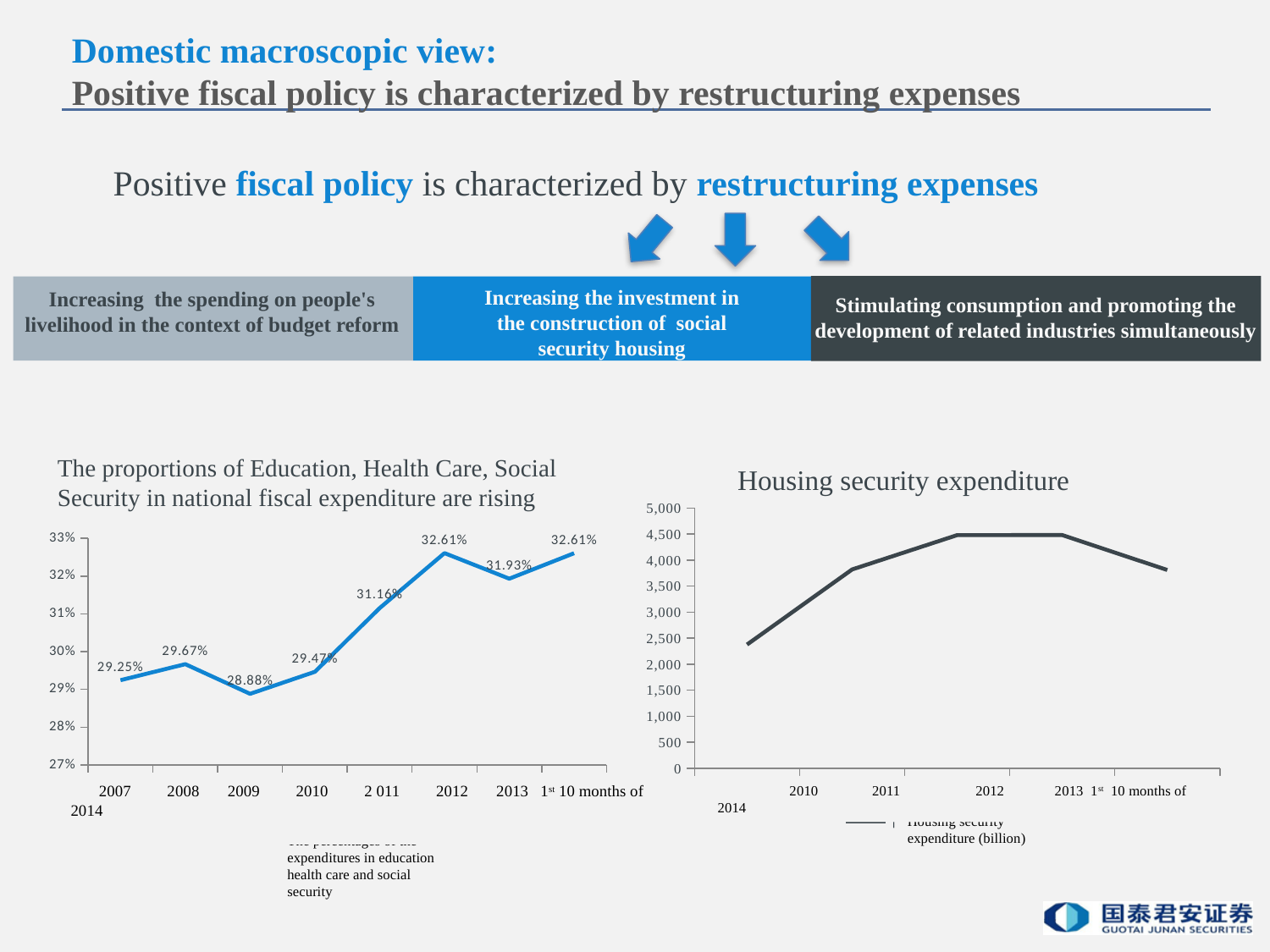
In the 'Housing security expenditure' chart, is the value for 2010 greater or less than 3,000? less How many data points are plotted in the 'Housing security expenditure' chart? 5 In the 'Housing security expenditure' chart, which year has the lowest value? 2010 In the left chart on the proportions of Education, Health Care, Social Security, which year has the lowest value? 2009 What kind of chart is the 'Housing security expenditure' chart? Line chart How many data points are plotted in the left chart on the proportions of Education, Health Care, Social Security? 8 In the 'Housing security expenditure' chart, do the values rise or fall from 2010 to 2012? rise In the left chart on the proportions of Education, Health Care, Social Security, which is larger, the value for 2008 or for 2010? 2008 In the left chart on the proportions of Education, Health Care, Social Security, what is the difference between the 2012 and 2011 values? 1.45% In the left chart on the proportions of Education, Health Care, Social Security, what is the value for 2009? 28.88% In the left chart on the proportions of Education, Health Care, Social Security, what is the value for 2012? 32.61% In the 'Housing security expenditure' chart, is the value for 2011 greater or less than 3,500? greater